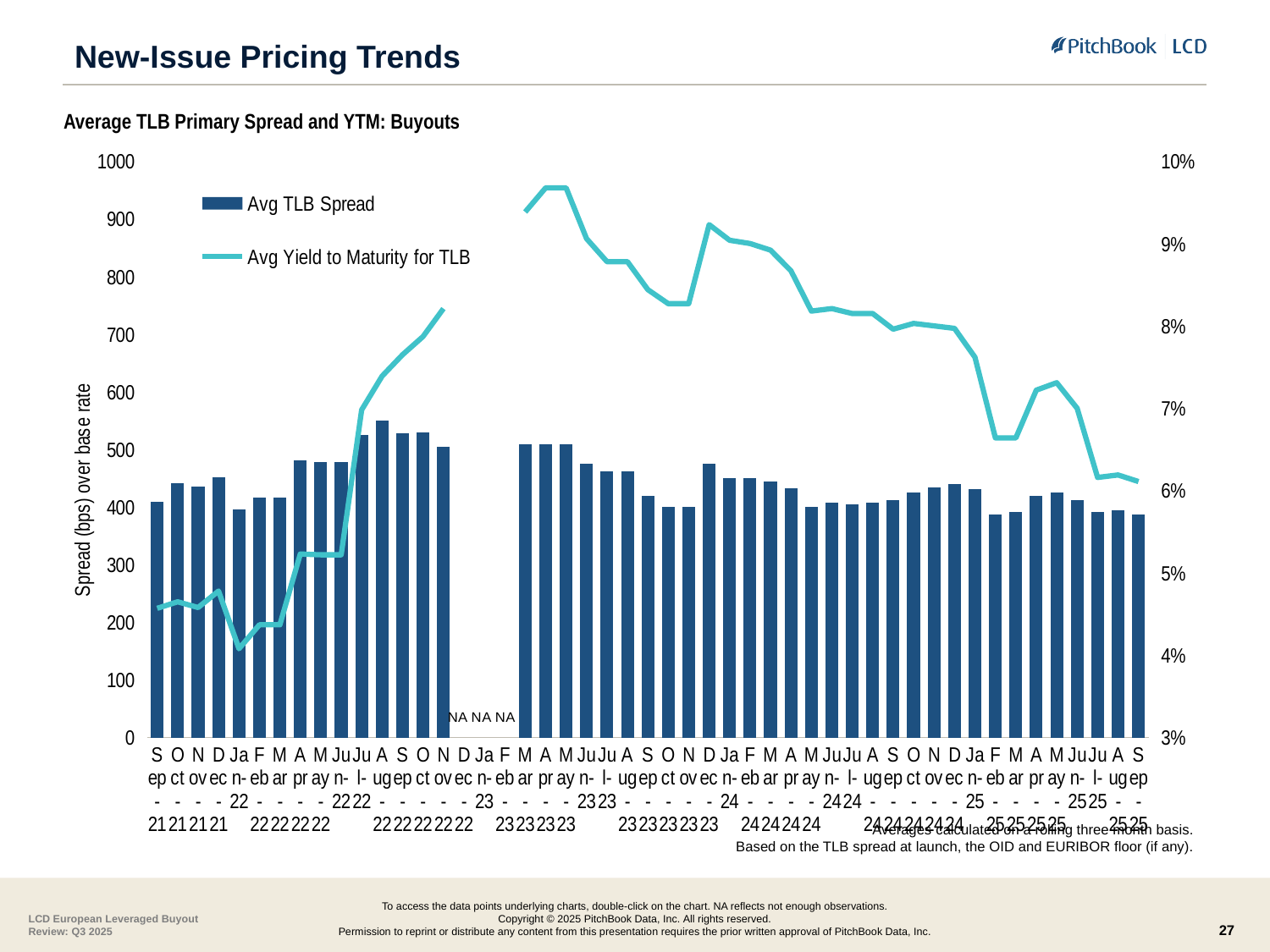
Which series is plotted as bars? Avg TLB Spread Is the tallest Avg TLB Spread bar greater or less than 500? greater Does the Avg Yield to Maturity for TLB line rise or fall from the start of 2024 to Sep-25? fall What kind of chart is shown on the slide? A combined bar and line chart What is the highest value shown on the left vertical axis? 1000 Which series is plotted as a line? Avg Yield to Maturity for TLB Is the Avg Yield to Maturity for TLB value at Sep-21 greater or less than 5%? less Is the peak of the Avg Yield to Maturity for TLB line greater or less than 9%? greater How many series does the legend list? 2